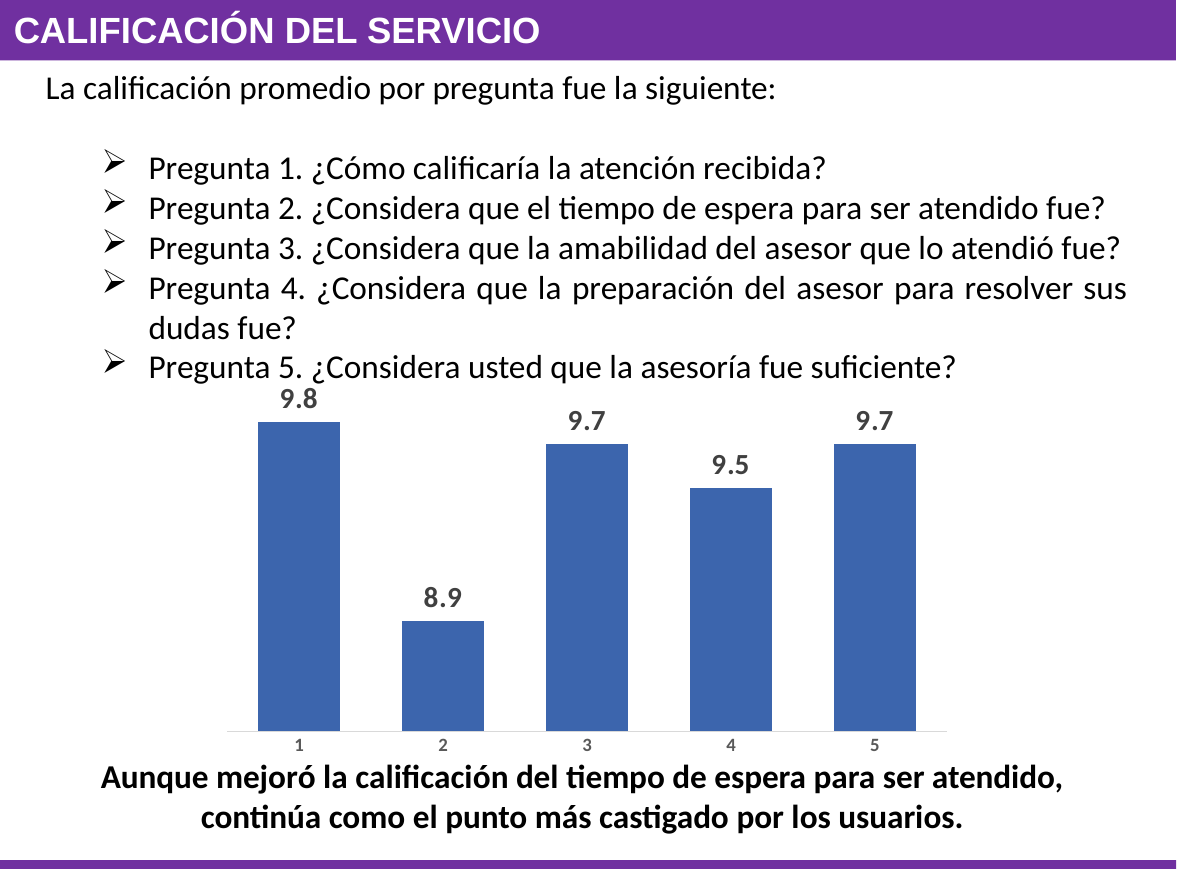
What kind of chart is shown on the slide? bar chart What is the value for category 1? 9.8 Which category has the lowest value? 2 What is the difference between the values for category 1 and category 2? 0.9 What colour are the bars in the chart? blue How many bars are shown in the chart? 5 What is the value for category 4? 9.5 Which category has the highest value? 1 What is the difference between the values for category 3 and category 4? 0.2 What is the value for category 2? 8.9 Which two categories share the same value of 9.7? 3 and 5 Which is larger, the value for category 4 or the value for category 5? 5